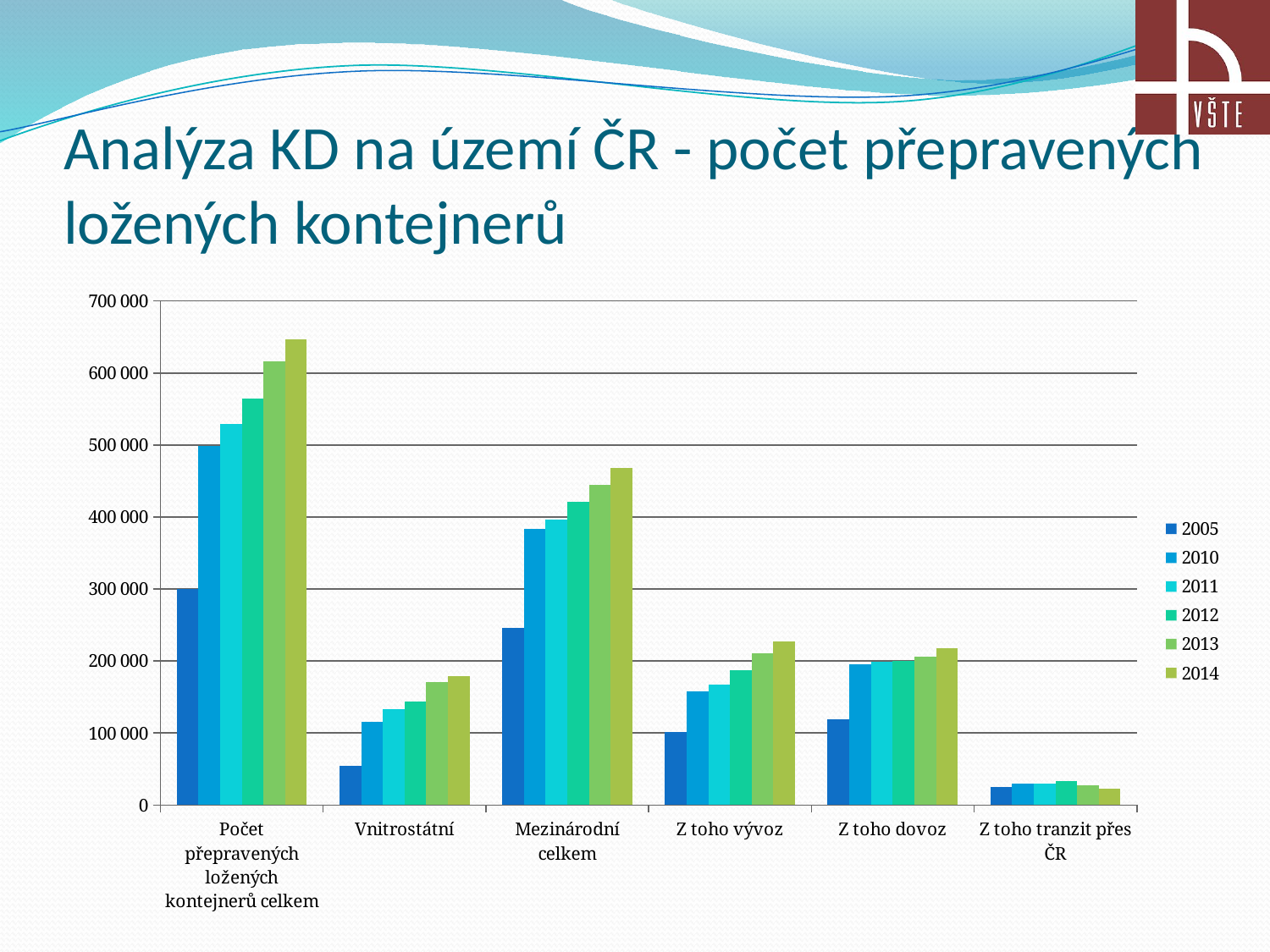
How many categories are shown on the x axis? 6 For 2005, which is larger: 'Mezinárodní celkem' or 'Vnitrostátní'? Mezinárodní celkem Is the value for 2005 in 'Vnitrostátní' greater or less than 100 000? less Is the value for 2014 in 'Mezinárodní celkem' greater or less than 400 000? greater What kind of chart is shown on the slide? bar chart Which category has the lowest values overall? Z toho tranzit přes ČR How many series does the legend list? 6 In the category 'Počet přepravených ložených kontejnerů celkem', which year has the highest value? 2014 Is the value for 2013 in 'Z toho tranzit přes ČR' greater or less than 100 000? less Which year is listed first in the legend? 2005 In the category 'Počet přepravených ložených kontejnerů celkem', do the values rise or fall from 2005 to 2014? rise